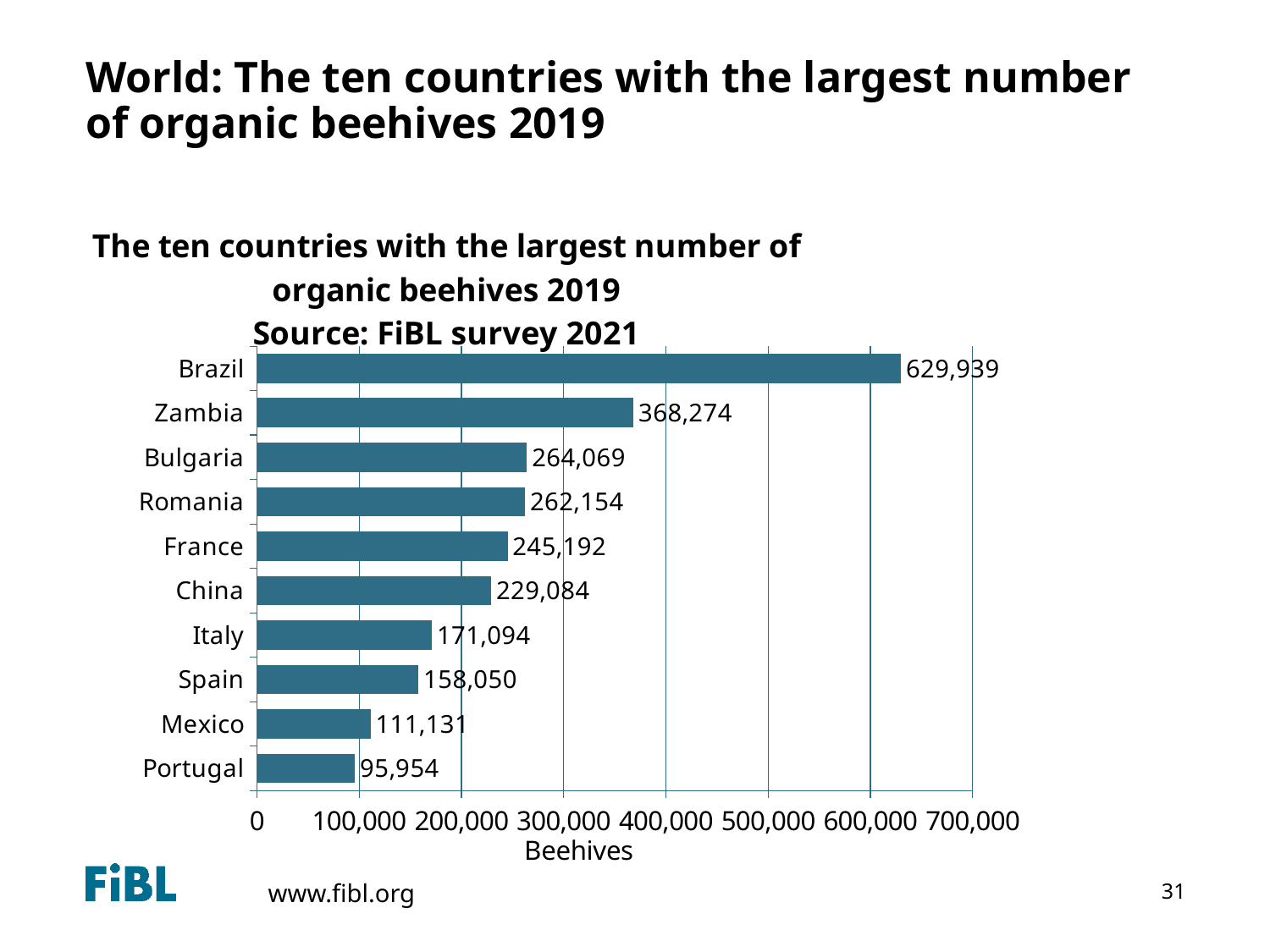
What kind of chart is shown on the slide? Bar chart Which country has the smallest number of organic beehives in the chart? Portugal How many organic beehives does Brazil have according to the chart? 629,939 What is the difference between the values for Italy and Spain? 13,044 What is the value shown for Zambia? 368,274 What is the label of the horizontal axis? Beehives What is the difference between the values for Brazil and Zambia? 261,665 How many countries are shown in the chart? 10 Which has more organic beehives, France or China? France What is the number of organic beehives shown for Portugal? 95,954 Is the value for Mexico greater or less than 100,000? greater Which country has the largest number of organic beehives in the chart? Brazil